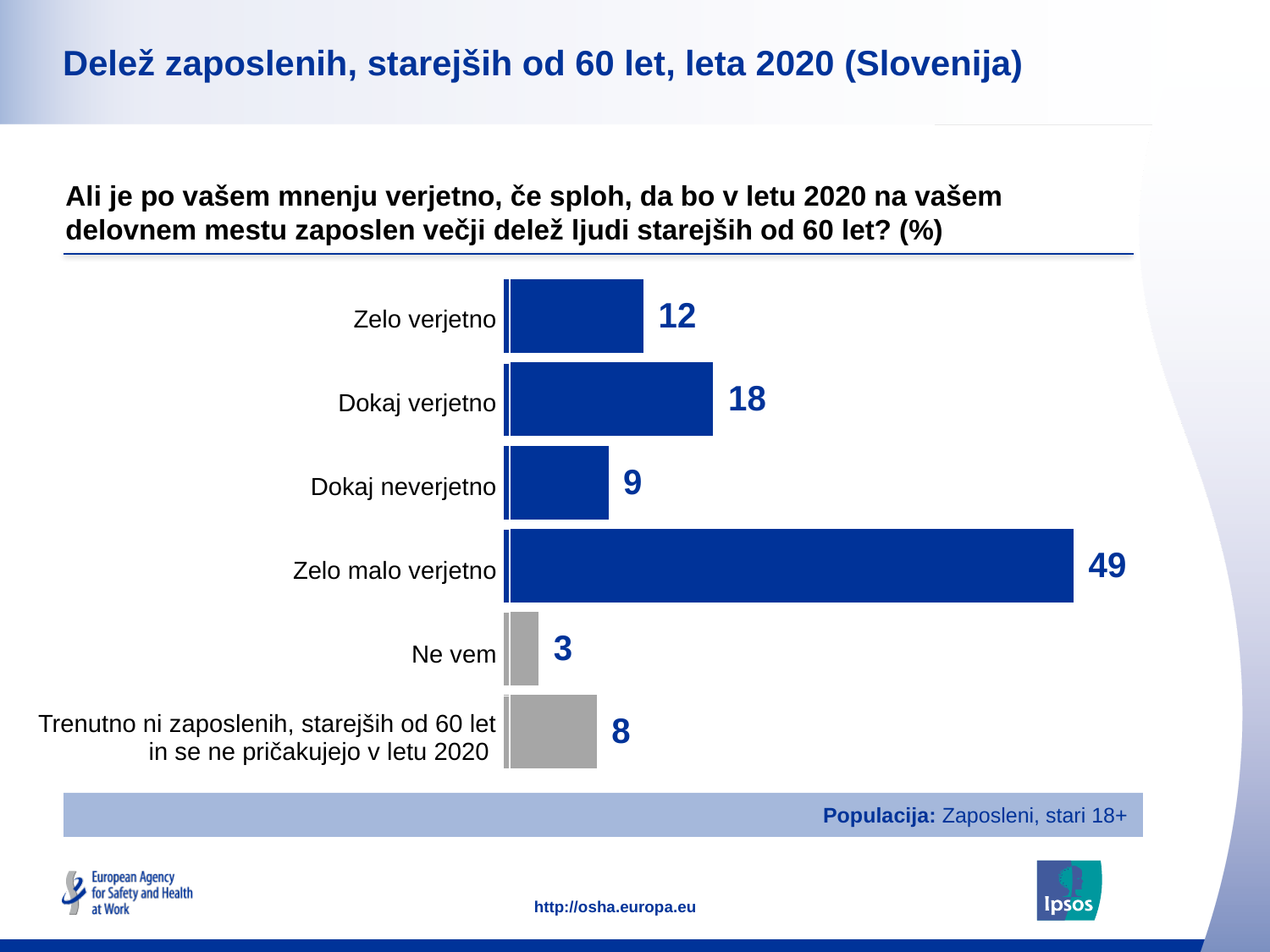
What is the value for "Dokaj verjetno"? 18 How many categories are shown in the chart? 6 What is the value for "Zelo malo verjetno"? 49 Which is larger, the value for "Dokaj neverjetno" or the value for "Trenutno ni zaposlenih, starejših od 60 let in se ne pričakujejo v letu 2020"? Dokaj neverjetno Which category has the highest value? Zelo malo verjetno What is the combined value of "Zelo verjetno" and "Dokaj verjetno"? 30 Which bars are coloured grey rather than blue? Ne vem and Trenutno ni zaposlenih, starejših od 60 let in se ne pričakujejo v letu 2020 What kind of chart is shown on the slide? Bar chart What is the value for "Zelo verjetno"? 12 What is the difference between the values for "Zelo malo verjetno" and "Dokaj verjetno"? 31 Which category has the lowest value? Ne vem What is the value for "Ne vem"? 3